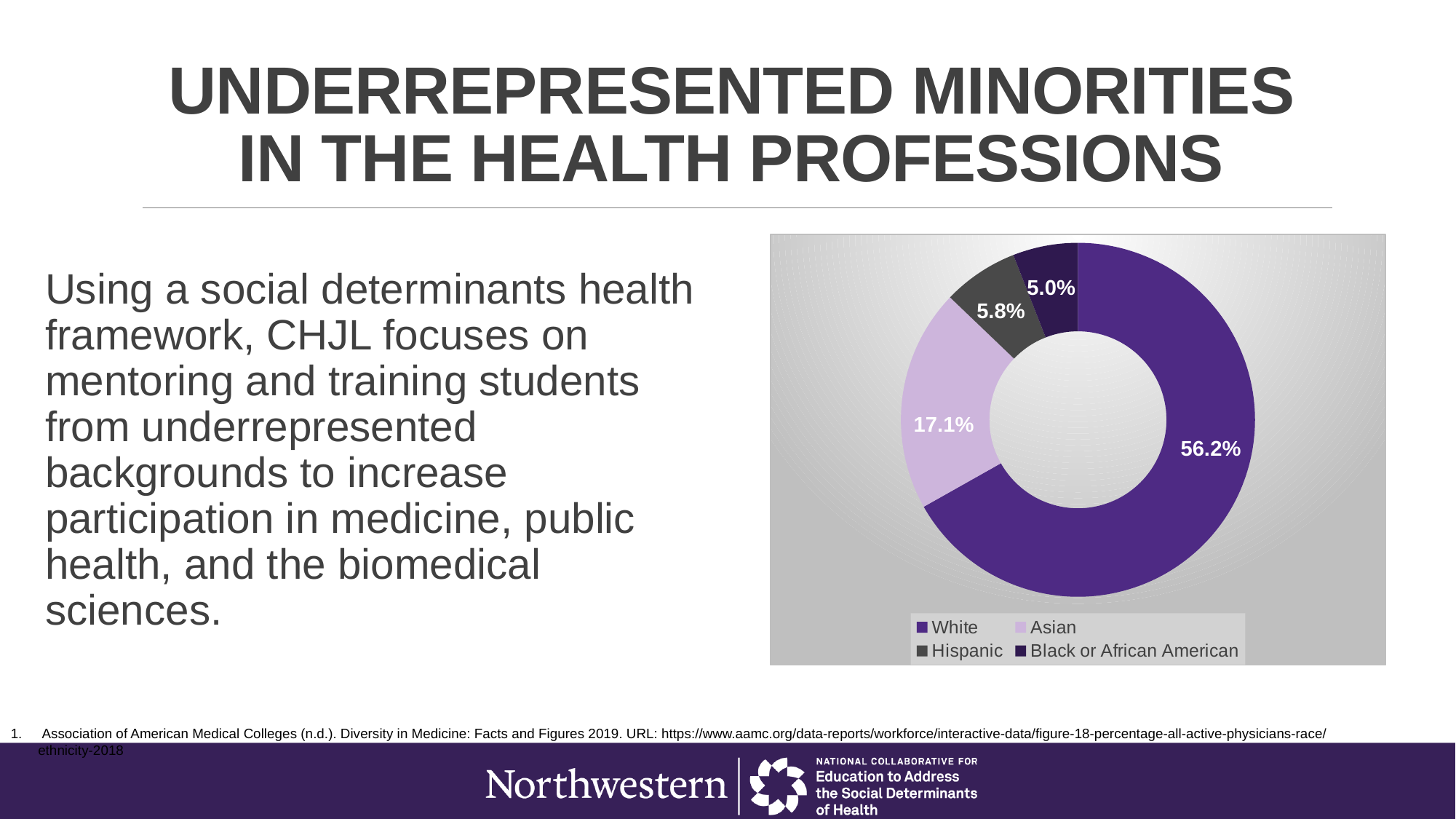
What is the difference in percentage points between the White and Asian slices? 39.1 Which category has the largest slice in the doughnut chart? White What percentage is shown for Black or African American in the doughnut chart? 5.0% What is the difference in percentage points between the Hispanic and Black or African American slices? 0.8 Which slice is larger, Asian or Hispanic? Asian How many categories does the doughnut chart show? 4 What percentage is shown for Hispanic in the doughnut chart? 5.8% Which category has the smallest slice in the doughnut chart? Black or African American What percentage is shown for White in the doughnut chart? 56.2% What kind of chart is shown on the slide? Doughnut chart What percentage is shown for Asian in the doughnut chart? 17.1% Which legend entry is shown with the lightest purple colour? Asian